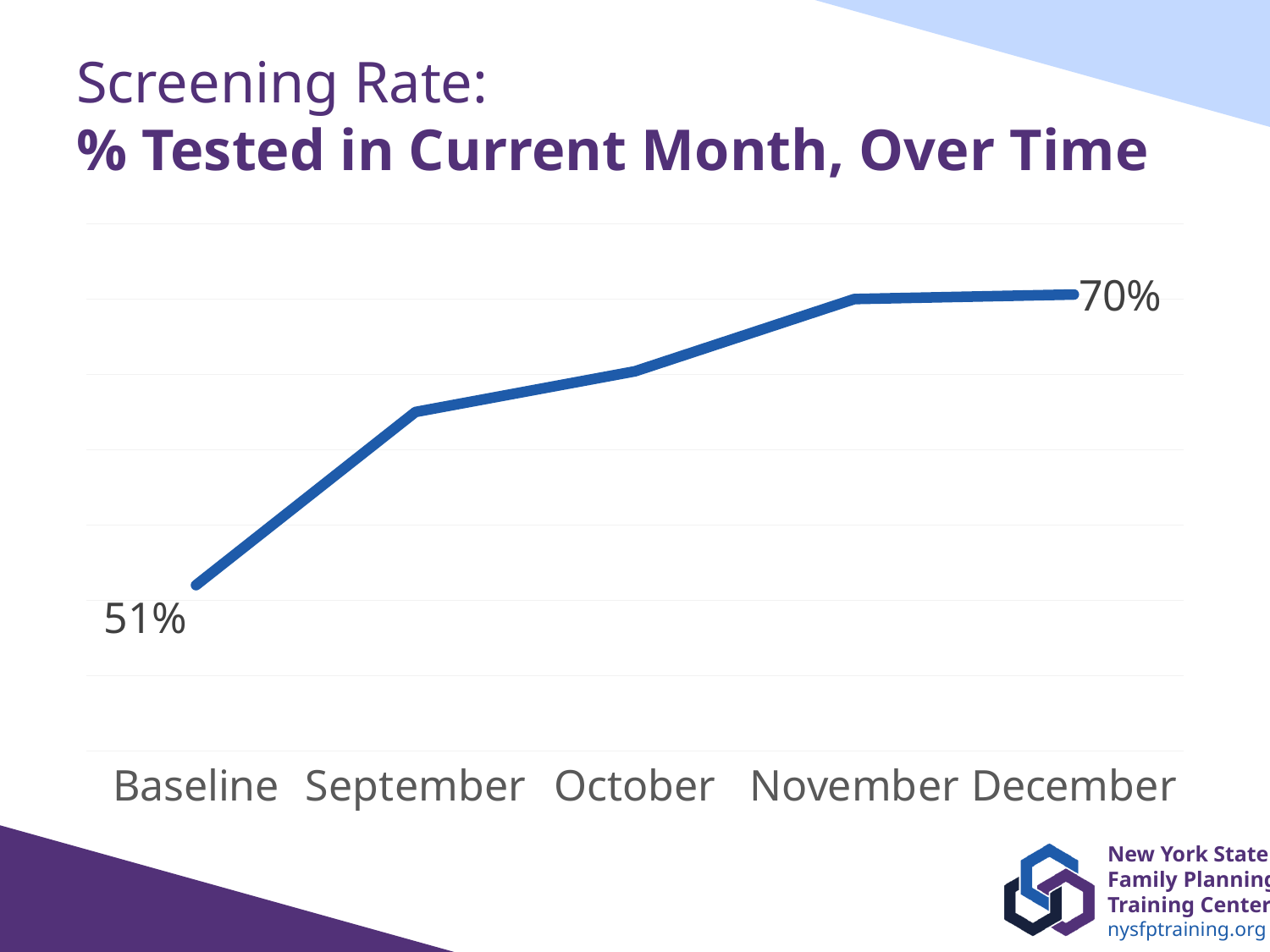
What is the value for December? 70% Which is larger, the value for September or the value for Baseline? September How many categories are plotted along the x axis? 5 What is the difference between the December value and the Baseline value? 19 percentage points What kind of chart is shown on the slide? Line chart Which category has the lowest value? Baseline Do the values rise or fall from Baseline to December? Rise What is the value for Baseline? 51% What is the title of the chart? Screening Rate: % Tested in Current Month, Over Time What is the first category on the x axis? Baseline Which is larger, the value for November or the value for October? November